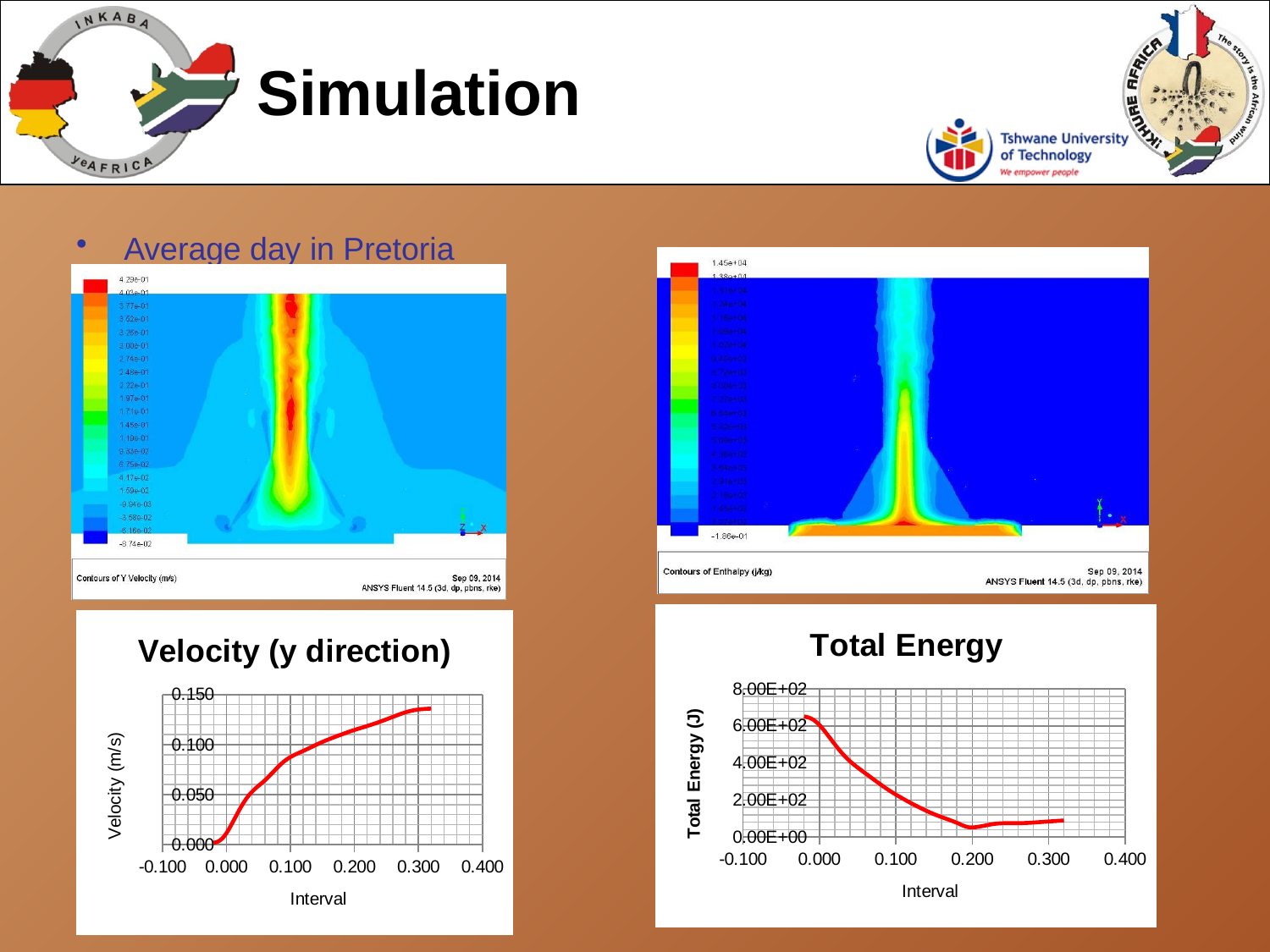
In the "Velocity (y direction)" chart, is the velocity at interval 0.000 greater or less than 0.050? less In the "Velocity (y direction)" chart, does the velocity rise or fall as the interval increases? rises In the "Velocity (y direction)" chart, which interval has the larger velocity, 0.100 or 0.300? 0.300 In the "Total Energy" chart, is the total energy at interval 0.200 greater or less than 2.00E+02? less In the "Total Energy" chart, is the total energy at interval 0.000 greater or less than 4.00E+02? greater What is the y-axis title of the "Total Energy" chart? Total Energy (J) What kind of chart is the "Velocity (y direction)" chart? line chart In the "Total Energy" chart, does the total energy rise or fall overall as the interval increases from 0.000 to 0.200? falls In the "Total Energy" chart, which interval has the larger total energy, 0.000 or 0.300? 0.000 What kind of chart is the "Total Energy" chart? line chart What is the x-axis title of the "Velocity (y direction)" chart? Interval